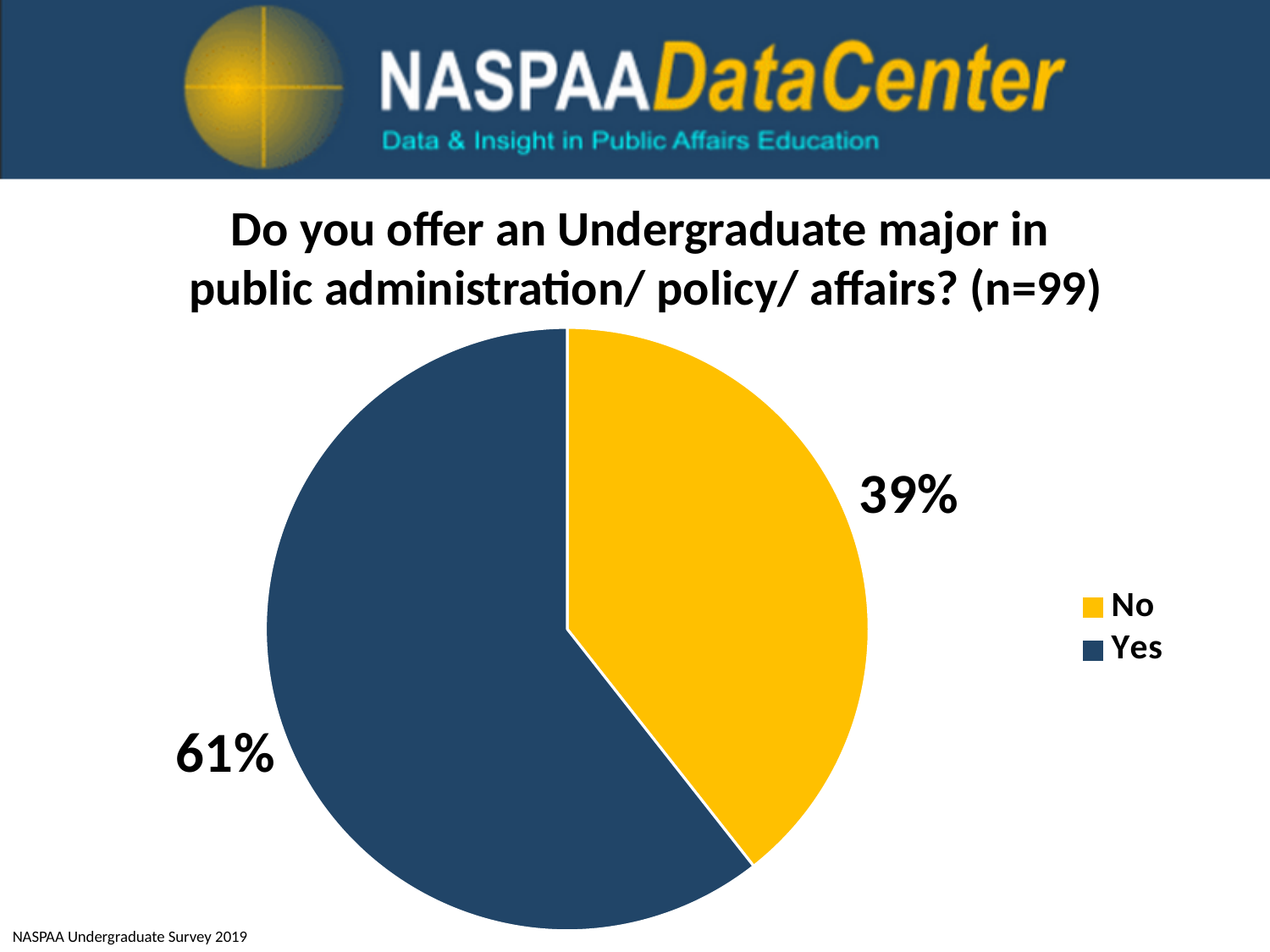
What colour is the "No" slice? yellow What kind of chart is shown on the slide? pie chart Which response has the largest share of the pie? Yes Is the share for "No" greater or less than 50%? less What percentage of respondents answered "No"? 39% What is the sample size (n) given in the chart title? 99 How many categories does the pie chart show? 2 Which is larger, the share for "Yes" or the share for "No"? Yes What is the difference in percentage points between the "Yes" and "No" shares? 22 Which response has the smallest share of the pie? No What percentage of respondents answered "Yes"? 61% What share of the pie does the "Yes" slice represent? 61%